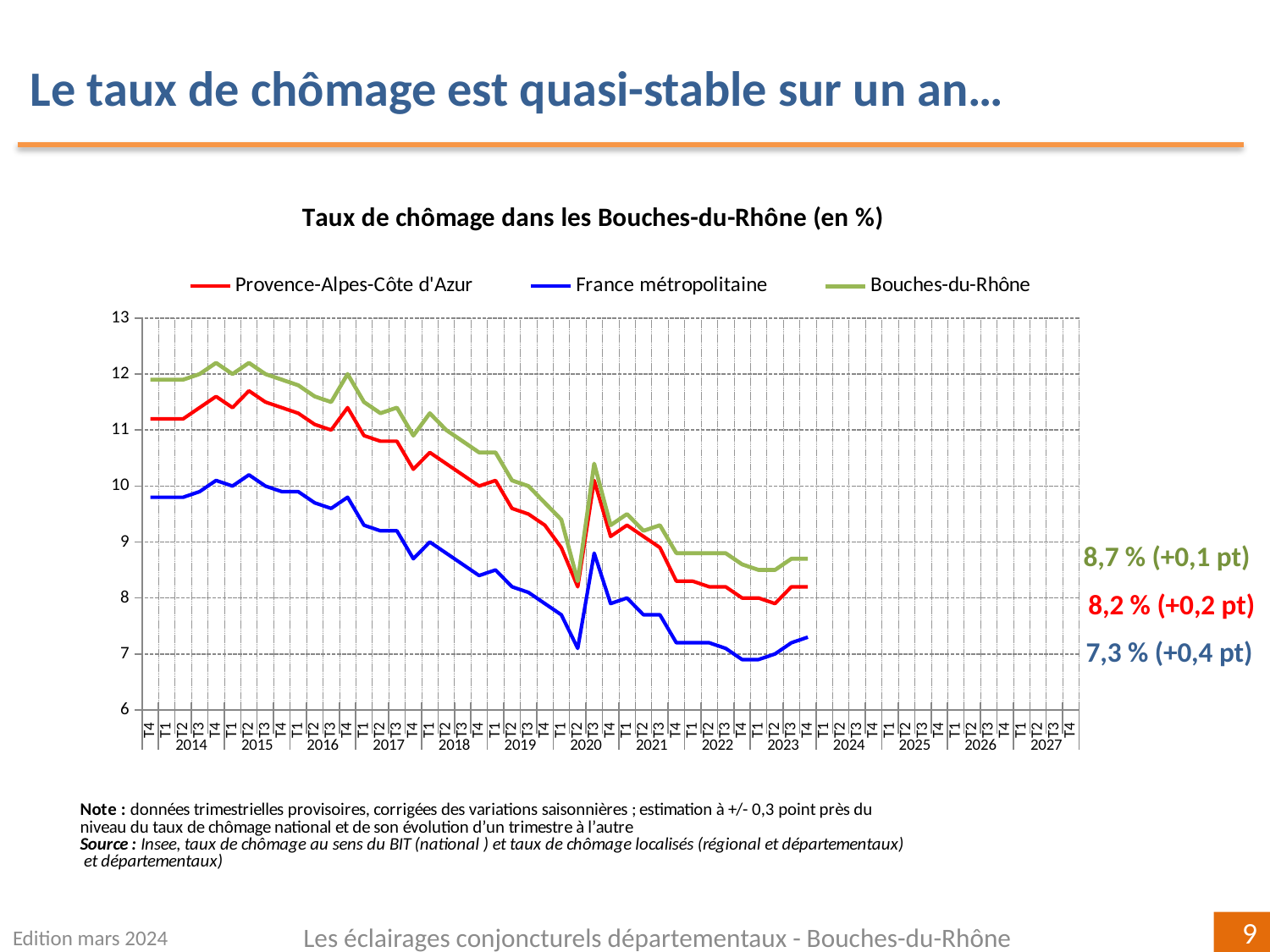
What kind of chart is shown on the slide? line chart What is the latest unemployment rate shown for France métropolitaine? 7,3 % How many series does the legend list? 3 By how many points did the France métropolitaine rate change over one year, according to the label? +0,4 pt Which series has the highest latest value: Bouches-du-Rhône or France métropolitaine? Bouches-du-Rhône What is the difference between the latest Bouches-du-Rhône rate and the latest Provence-Alpes-Côte d'Azur rate? 0,5 What is the difference between the latest Bouches-du-Rhône rate and the latest France métropolitaine rate? 1,4 What is the latest unemployment rate shown for Provence-Alpes-Côte d'Azur? 8,2 % Is the value for France métropolitaine in T2 2020 greater or less than 8? less Which series has the lowest values across the whole period? France métropolitaine What is the latest unemployment rate shown for Bouches-du-Rhône? 8,7 % Overall, do the unemployment rates rise or fall between 2014 and 2023? fall